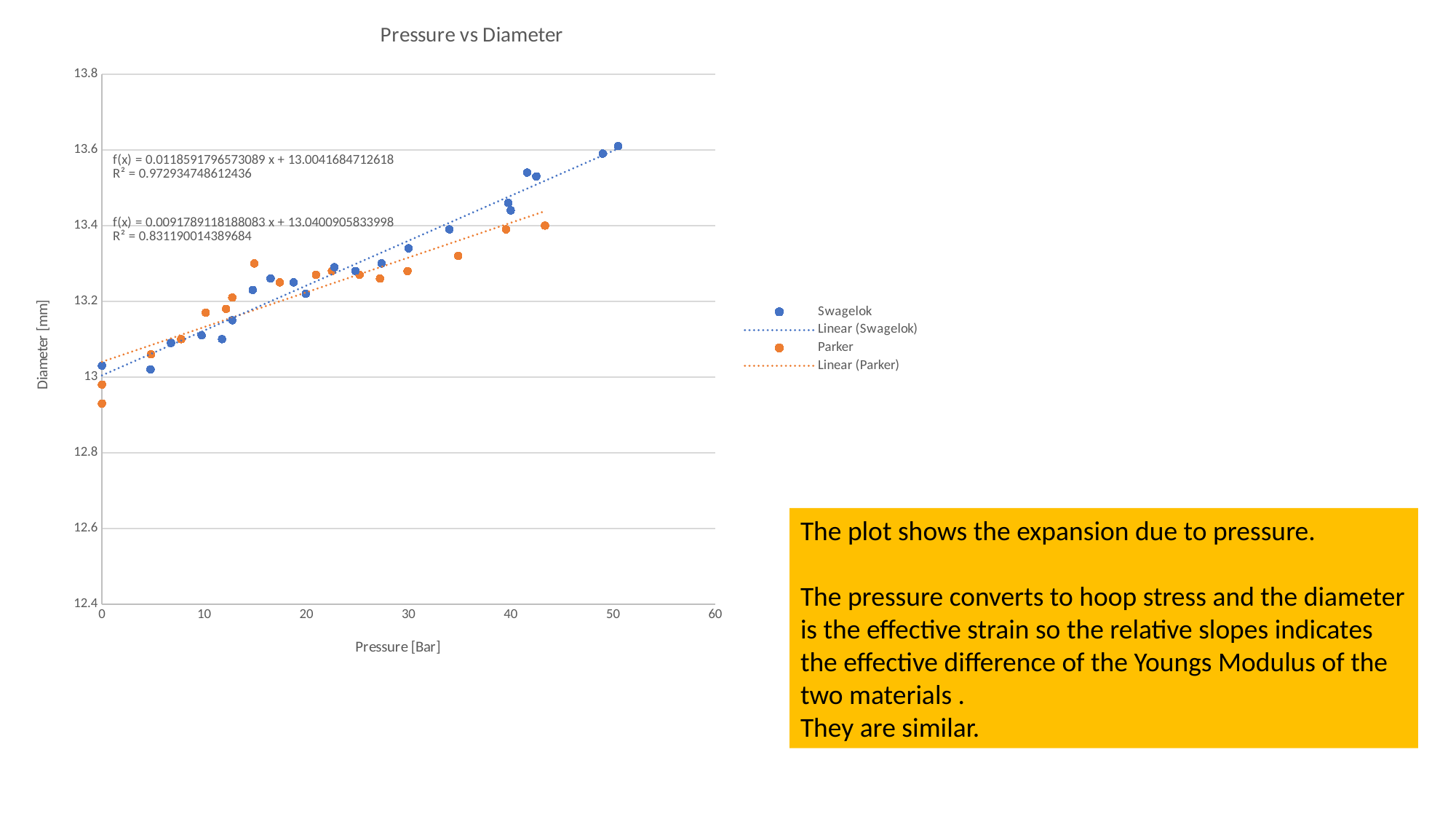
What is the larger of the two R² values printed on the chart? 0.972934748612436 How many data series (sets of points) are plotted in the chart? 2 What is the label of the y axis? Diameter [mm] Is the Parker diameter at about 35 bar greater or less than 13.2? greater Is the Swagelok diameter at about 42 bar greater or less than 13.4? greater What is the title of the chart? Pressure vs Diameter What is the smaller of the two R² values printed on the chart? 0.831190014389684 Is the lowest Parker point at 0 bar greater or less than 13 mm? less What kind of chart is shown on the slide? scatter chart Which series reaches the larger maximum diameter, Swagelok or Parker? Swagelok As pressure increases along the x axis, does the diameter rise or fall? rise How many entries does the chart legend list? 4